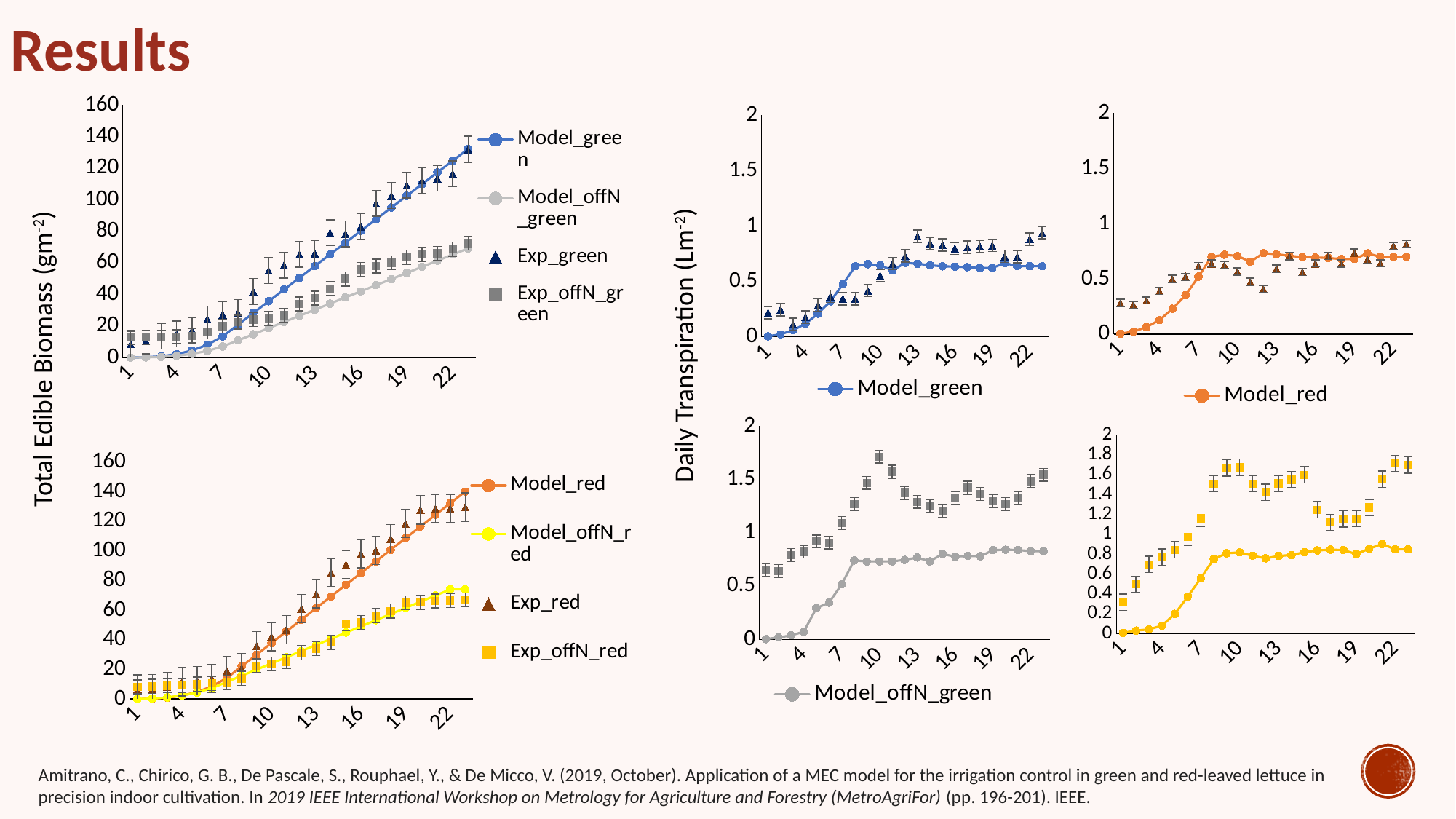
In the top-left biomass chart, is the Model_green value at day 22 greater or less than 100? greater What is the y-axis label shared by the two charts on the left of the slide? Total Edible Biomass (gm-2) In the top-left biomass chart, is the Model_offN_green value at day 22 greater or less than 80? less How many series does the legend of the bottom-left biomass chart list? 4 In the top-middle Daily Transpiration chart, is the Model_green value at day 22 greater or less than 1? less In the bottom-left biomass chart, which series is larger at day 22, Model_red or Model_offN_red? Model_red How many series does the legend of the top-middle Daily Transpiration chart list? 1 In the top-left biomass chart, does the Model_green series rise or fall along the x axis? rise How many series does the legend of the top-left biomass chart list? 4 What kind of chart is the top-left chart with the Model_green legend entry? line chart